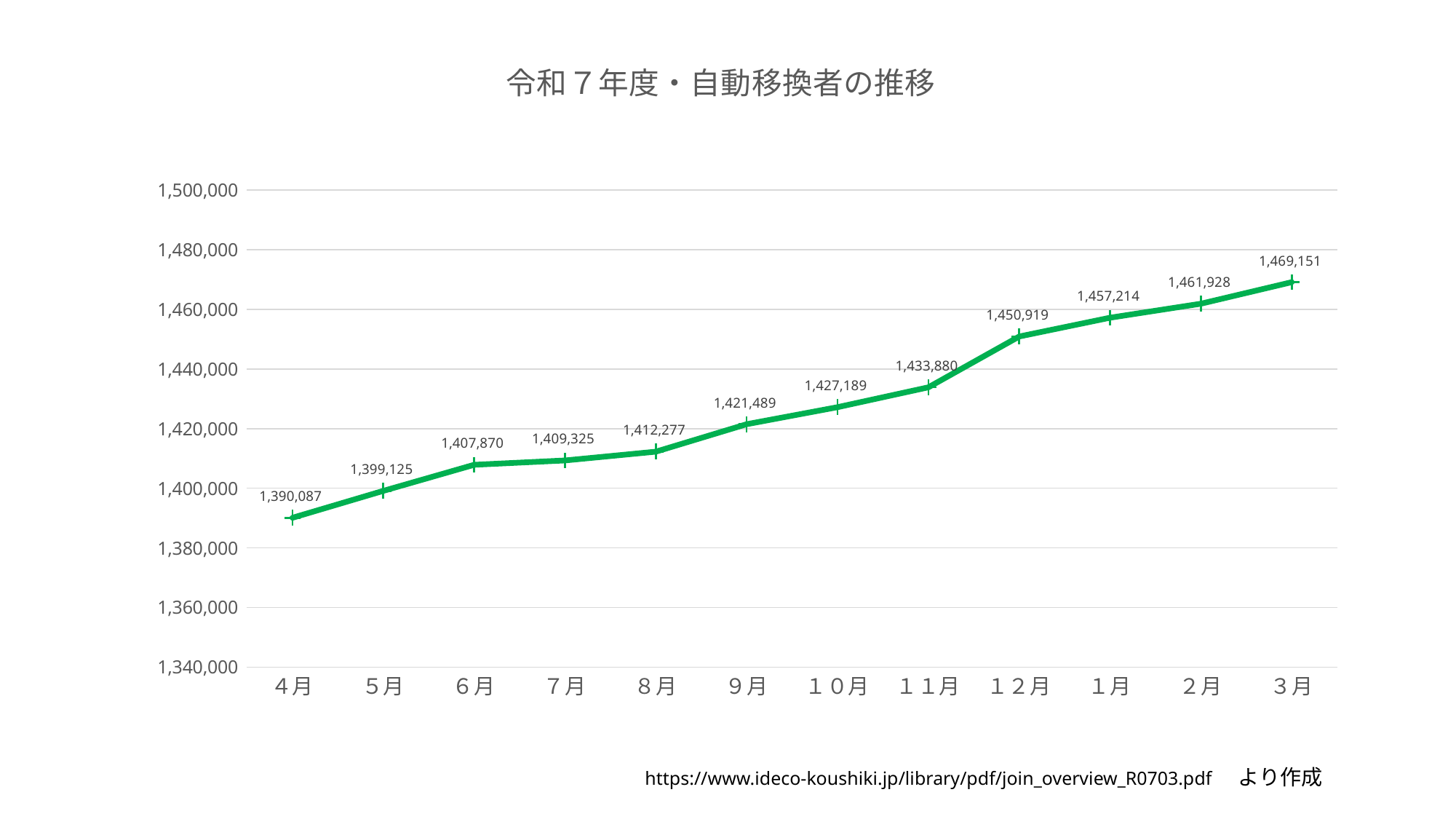
What is the value for 4月? 1,390,087 What is the difference between the values for 3月 and 4月? 79,064 What kind of chart is shown on the slide? line chart What is the value for 12月? 1,450,919 Is the value for 8月 greater or less than 1,420,000? less Which month has the highest value? 3月 Which month has the lowest value? 4月 Which is larger, the value for 7月 or the value for 10月? 10月 What is the value for 9月? 1,421,489 Do the values rise or fall from 4月 to 3月? rise How many months are plotted on the chart? 12 What is the difference between the values for 12月 and 11月? 17,039